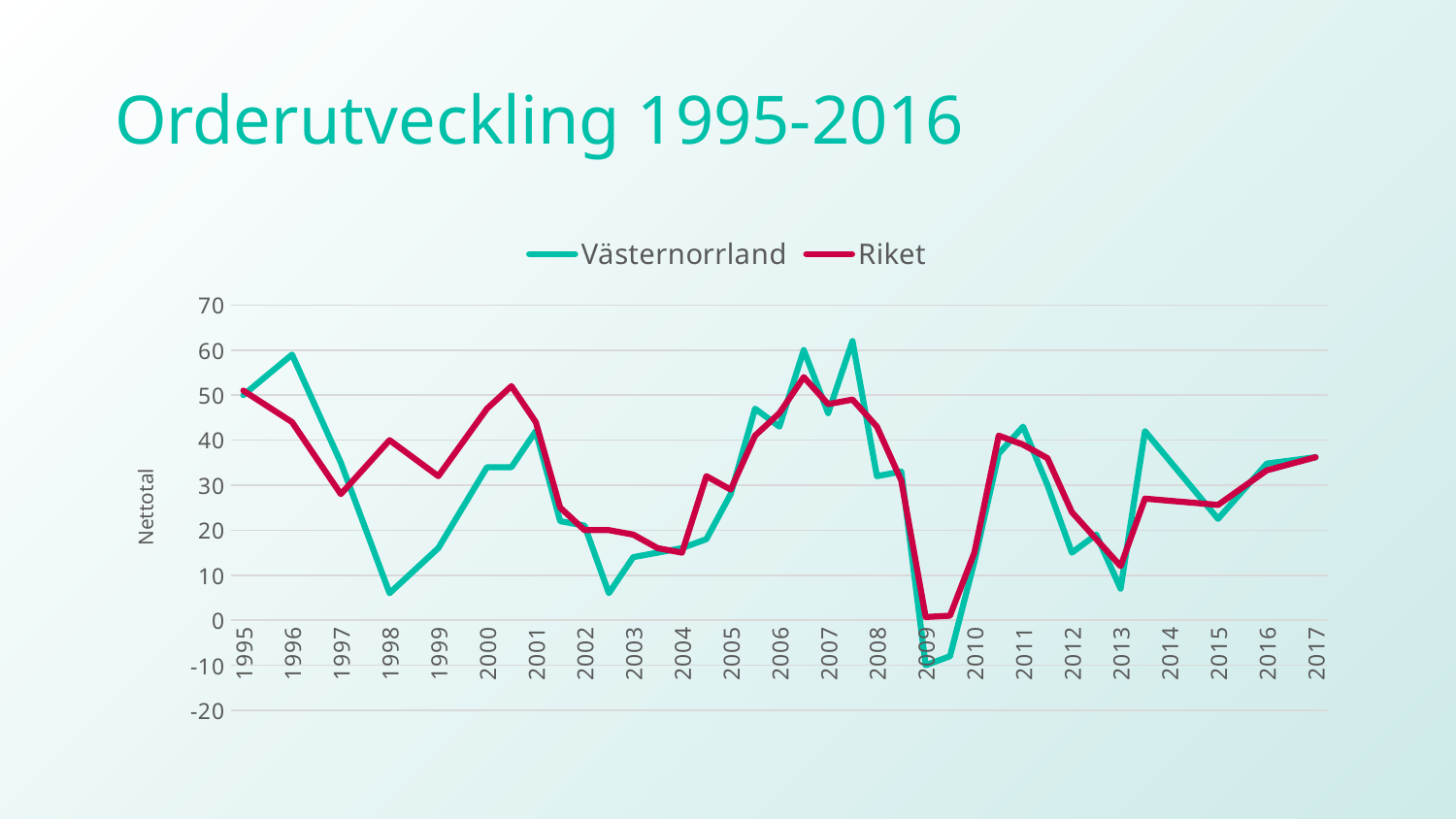
Which series has the higher value in 2014, Västernorrland or Riket? Västernorrland Which series has the higher value in 1998, Västernorrland or Riket? Riket What are the two series named in the legend? Västernorrland and Riket Do the values for both series rise or fall between 2009 and 2011? rise Is the value for Västernorrland in 1998 greater or less than 10? less Is the value for Västernorrland in 1996 greater or less than 50? greater What kind of chart is shown on the slide? line chart What is the label on the vertical axis? Nettotal In which year does the Riket series reach its lowest value? 2009 How many series does the legend list? 2 How many year labels are shown along the x axis? 23 Is the value for Riket in 2013 greater or less than 20? less